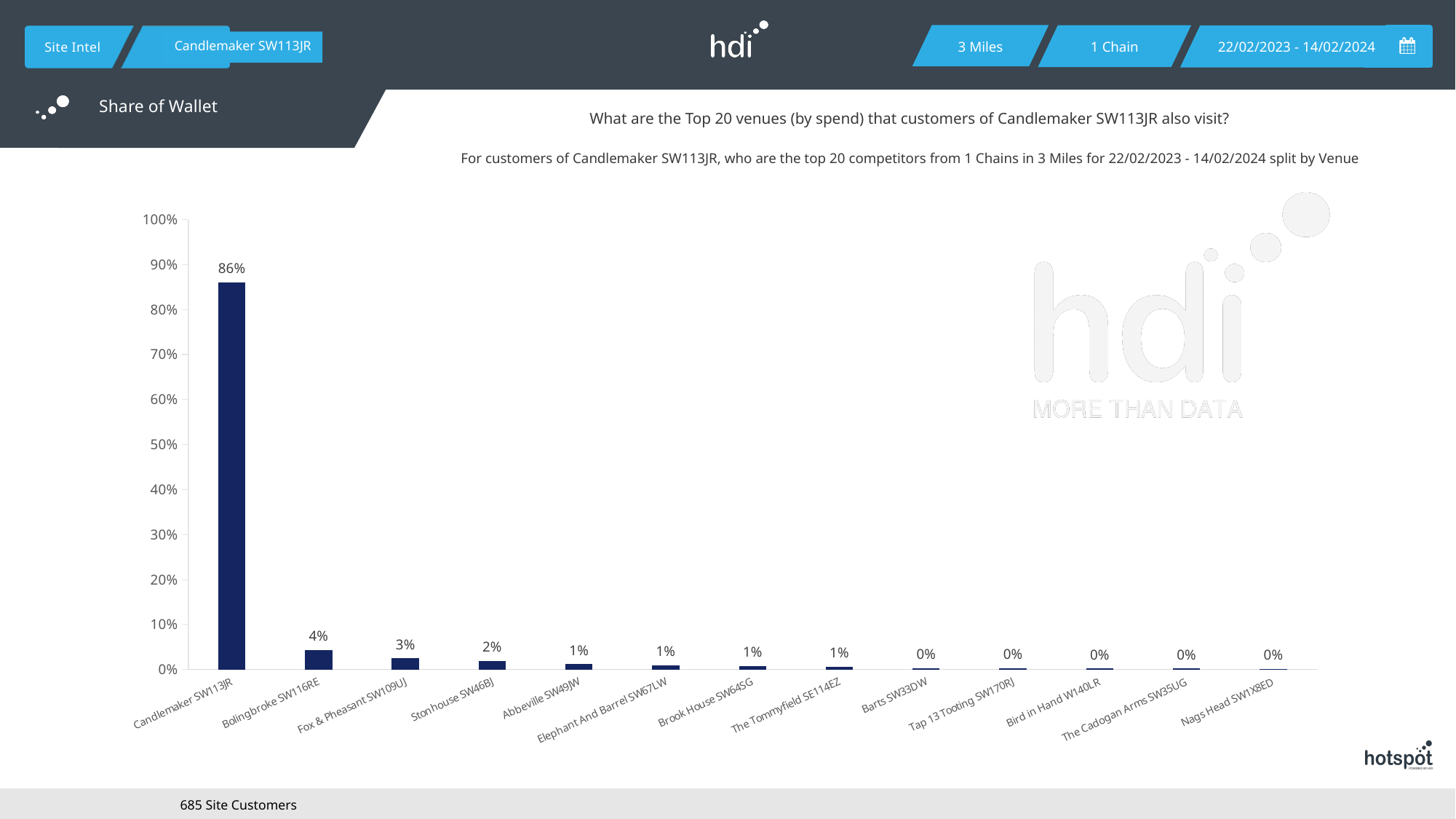
What is the value for Stonhouse SW46BJ? 2% What is the value for Candlemaker SW113JR? 86% What kind of chart is shown on the slide? bar chart How many venues are shown on the chart? 13 What is the difference between the values for Candlemaker SW113JR and Bolingbroke SW116RE? 82% What is the value for Bolingbroke SW116RE? 4% Is the value for Candlemaker SW113JR greater or less than 80%? greater What is the difference between the values for Bolingbroke SW116RE and Fox & Pheasant SW109UJ? 1% Which venue has the highest value? Candlemaker SW113JR What is the value for Fox & Pheasant SW109UJ? 3% Which is larger, the value for Bolingbroke SW116RE or the value for Stonhouse SW46BJ? Bolingbroke SW116RE What is the value for Barts SW33DW? 0%